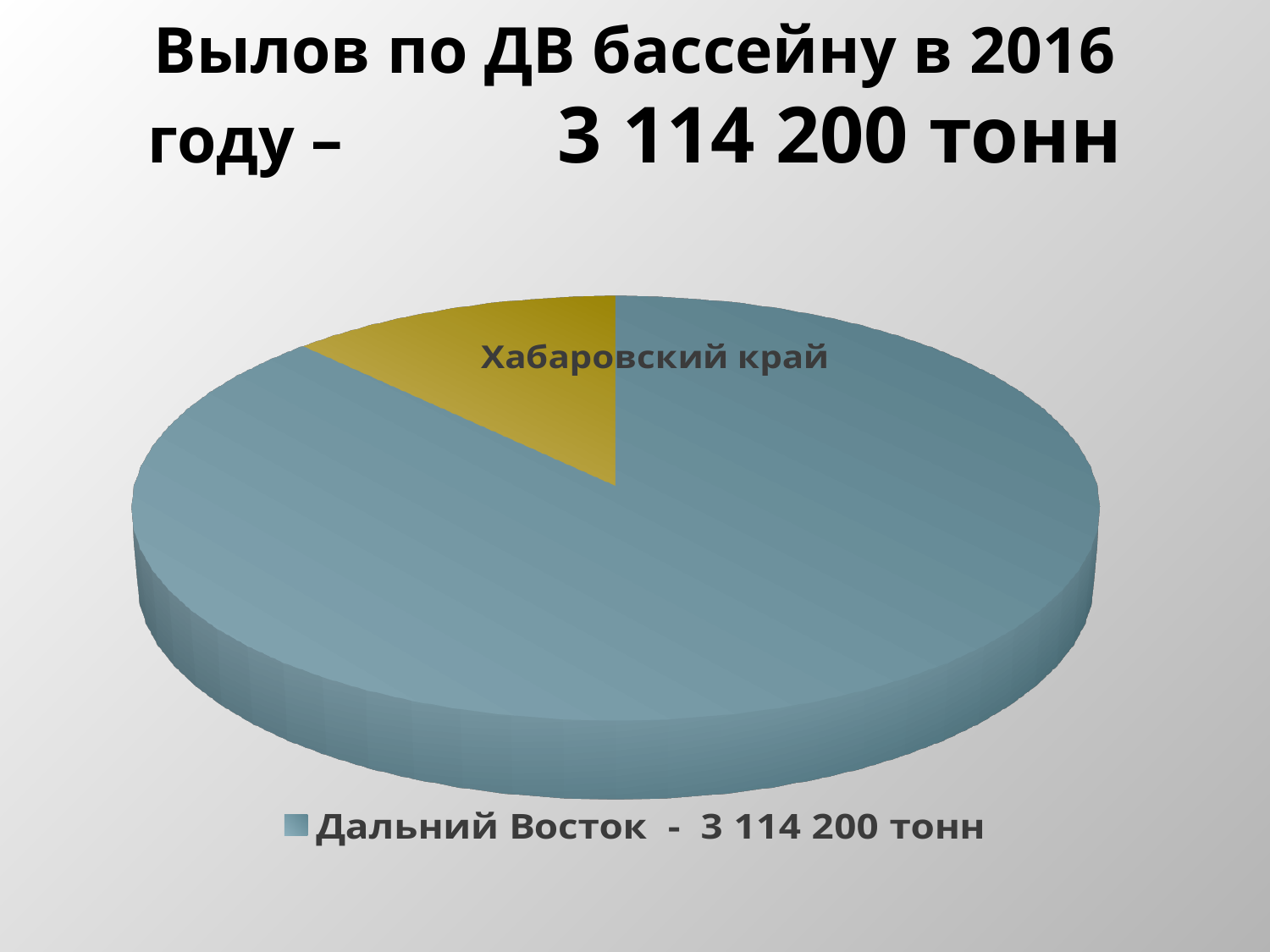
What colour is the slice labelled Хабаровский край? yellow What value is given for Дальний Восток in the legend? 3 114 200 тонн How many slices does the pie chart have? 2 Which slice of the pie chart is the largest? Дальний Восток How many entries does the legend of the pie chart list? 1 Which slice of the pie chart is the smallest? Хабаровский край Which slice is larger: Дальний Восток or Хабаровский край? Дальний Восток What kind of chart is shown on the slide? pie chart What is the title of the chart on the slide? Вылов по ДВ бассейну в 2016 году – 3 114 200 тонн